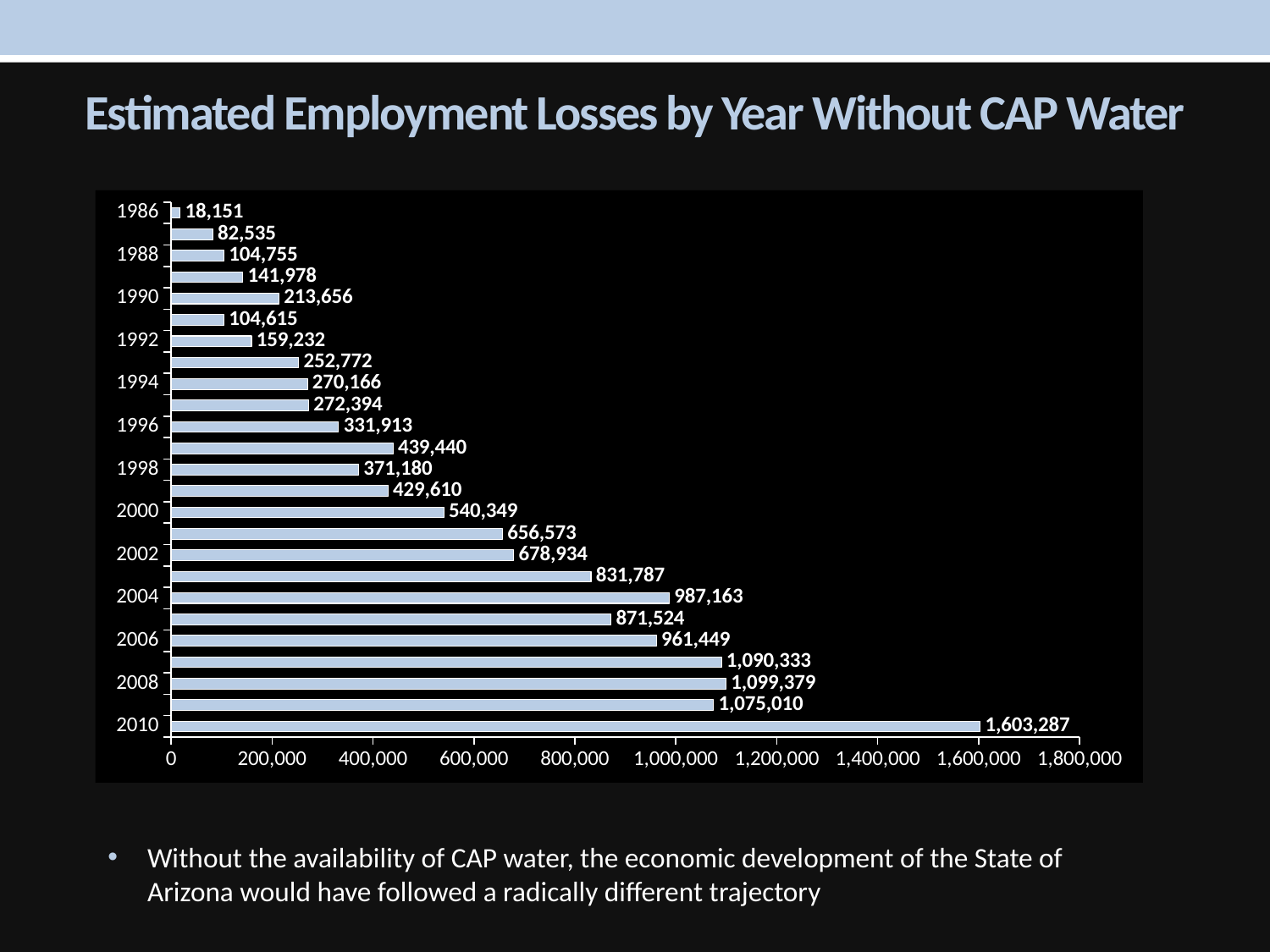
What kind of chart is shown on the slide? bar chart What is the difference between the estimated employment losses for 2010 and 2008? 503,908 Is the value for 2002 greater or less than 600,000? greater Do the estimated employment losses generally rise or fall from 1986 to 2010? rise How many bars (years) are plotted in the chart? 25 Which year has the lowest estimated employment loss? 1986 What is the title of the chart on the slide? Estimated Employment Losses by Year Without CAP Water Which year has the highest estimated employment loss? 2010 Which year has the larger estimated employment loss, 2004 or 2006? 2004 What is the estimated employment loss for 1986? 18,151 What is the estimated employment loss for 2010? 1,603,287 What is the estimated employment loss for 2000? 540,349